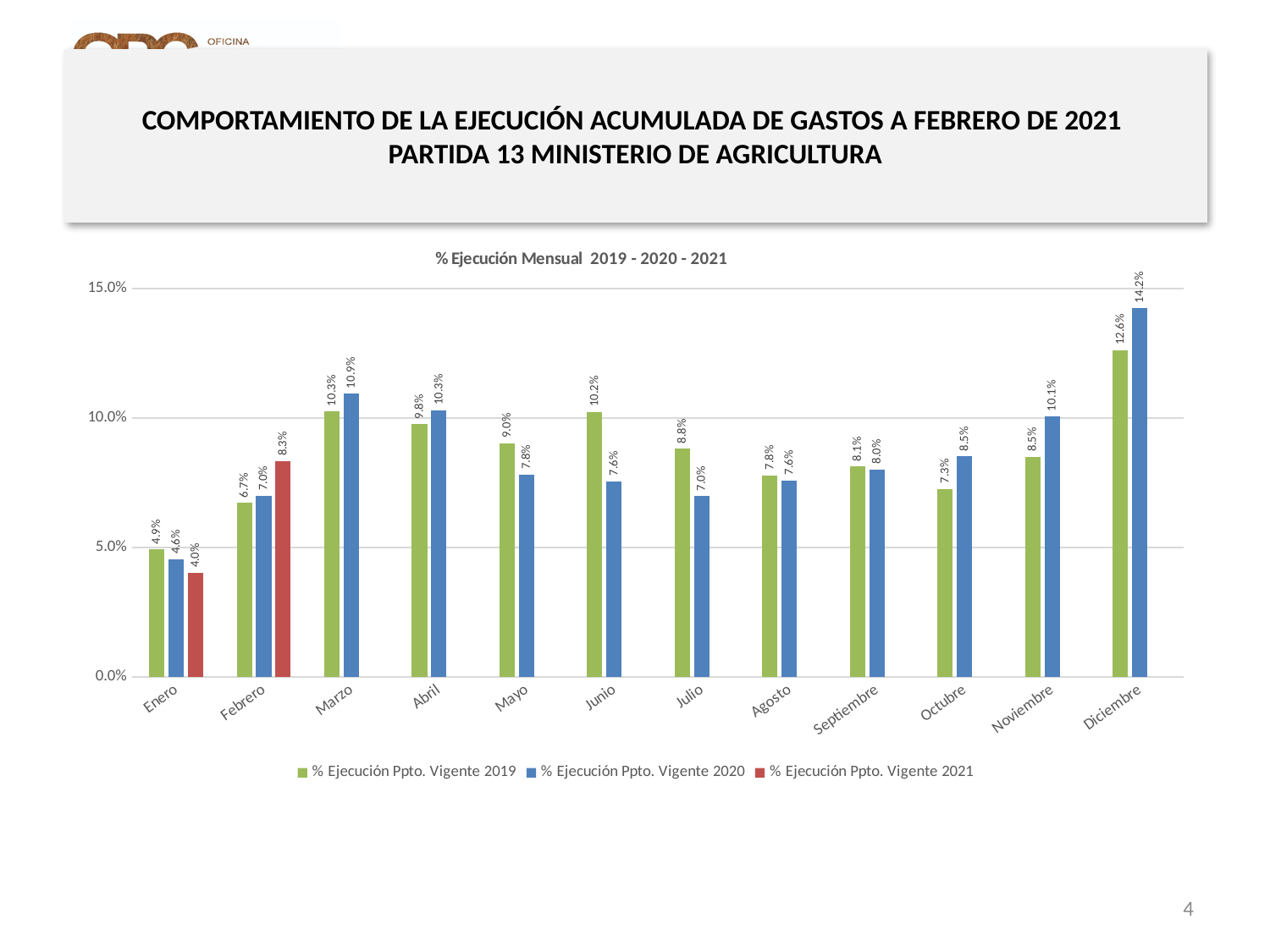
What is the value for % Ejecución Ppto. Vigente 2020 in Noviembre? 10.1% How many series does the legend list? 3 How many months are shown on the x axis? 12 What kind of chart is shown on the slide? Bar chart Is the value for % Ejecución Ppto. Vigente 2020 in Marzo greater or less than 10.0%? greater Which month has the lowest value for % Ejecución Ppto. Vigente 2019? Enero What is the title of the chart? % Ejecución Mensual 2019 - 2020 - 2021 In Mayo, which series has the larger value, % Ejecución Ppto. Vigente 2019 or % Ejecución Ppto. Vigente 2020? % Ejecución Ppto. Vigente 2019 Which month has the highest value for % Ejecución Ppto. Vigente 2020? Diciembre What is the difference between the 2020 and 2019 values in Diciembre? 1.6% What is the value for % Ejecución Ppto. Vigente 2021 in Febrero? 8.3% What is the value for % Ejecución Ppto. Vigente 2019 in Junio? 10.2%